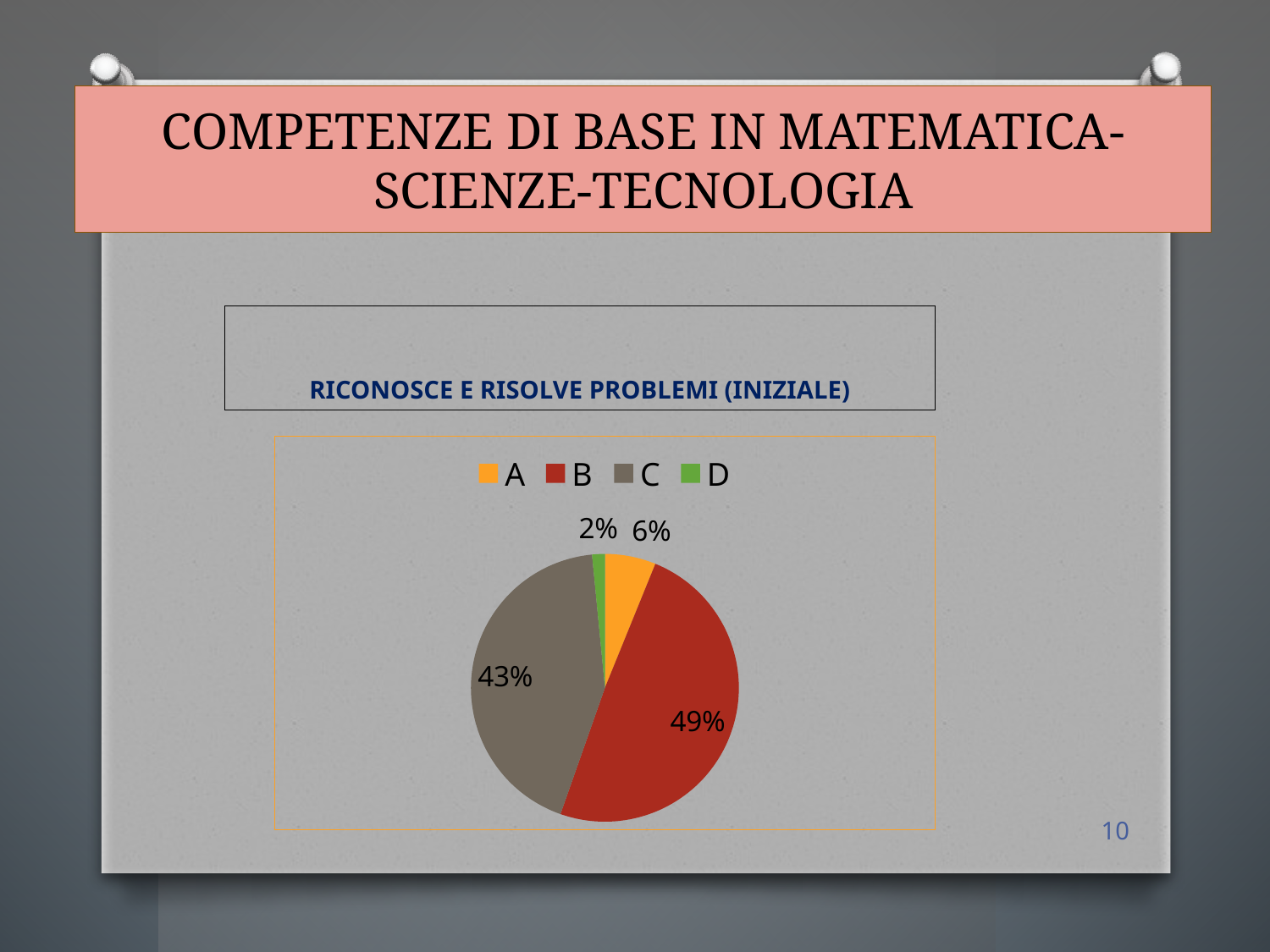
Which category has the smallest slice of the pie? D What kind of chart is shown on the slide? pie chart What colour represents category C in the pie chart? grey What percentage is shown for category C? 43% What is the title of the chart? RICONOSCE E RISOLVE PROBLEMI (INIZIALE) Which category has the largest slice of the pie? B What percentage is shown for category A? 6% How many categories does the legend list? 4 Which is larger, the share for category A or the share for category D? A What is the difference in percentage points between category B and category C? 6 What percentage is shown for category B? 49% What percentage is shown for category D? 2%